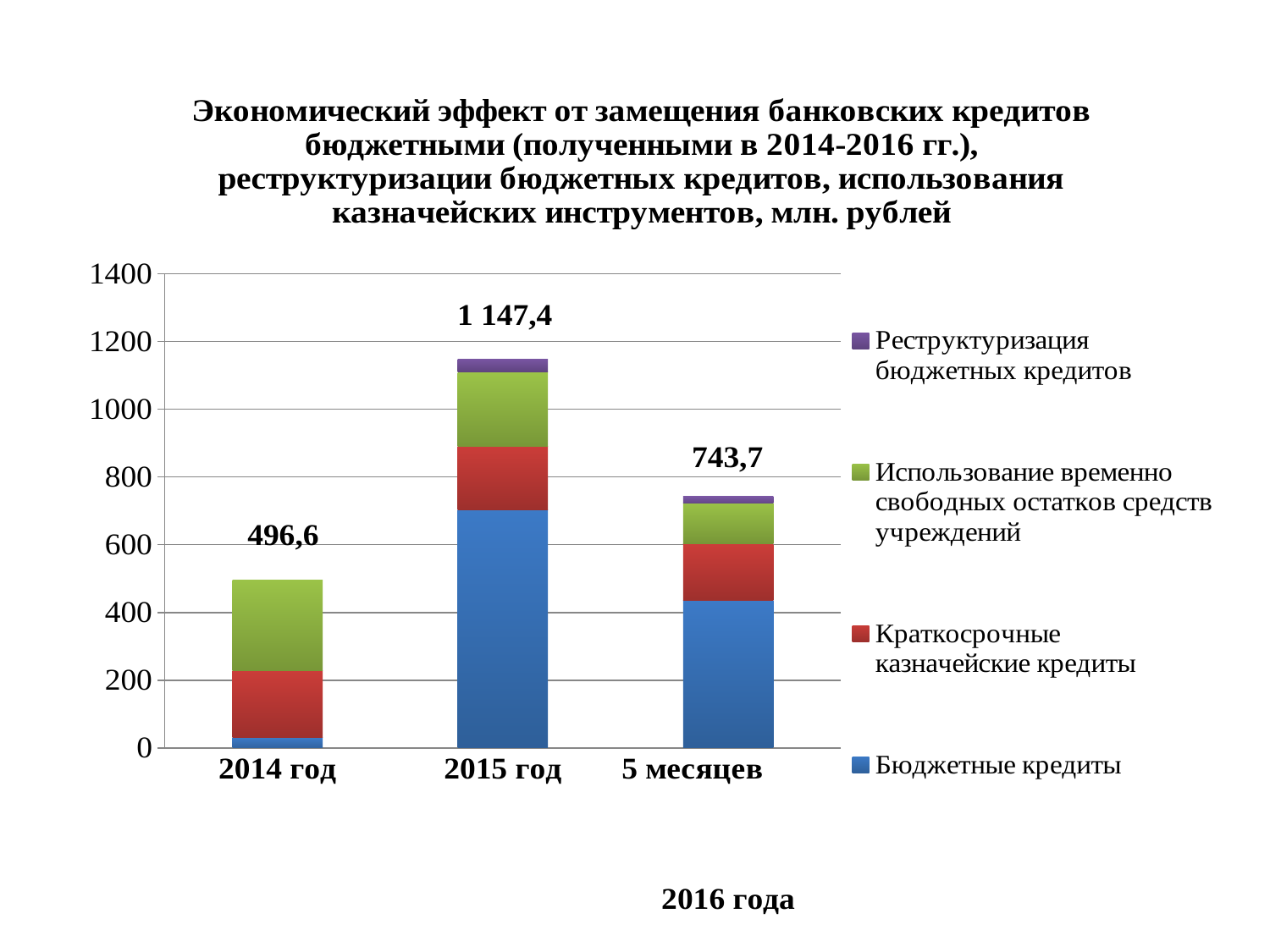
How many series does the legend list? 4 What is the total value labelled for the 2015 год bar? 1 147,4 What type of chart is shown on the slide? Stacked bar chart What is the total value labelled for the 2014 год bar? 496,6 What is the difference between the total for 2015 год and the total for 2014 год? 650,8 What is the total value labelled for the 5 месяцев 2016 года bar? 743,7 Which category has the highest total value? 2015 год What is the difference between the total for 2015 год and the total for 5 месяцев 2016 года? 403,7 Is the value of Бюджетные кредиты for 2014 год greater or less than 200? less Which category has the lowest total value? 2014 год Which total is larger: 2014 год or 5 месяцев 2016 года? 5 месяцев 2016 года Is the value of Бюджетные кредиты for 2015 год greater or less than 600? greater